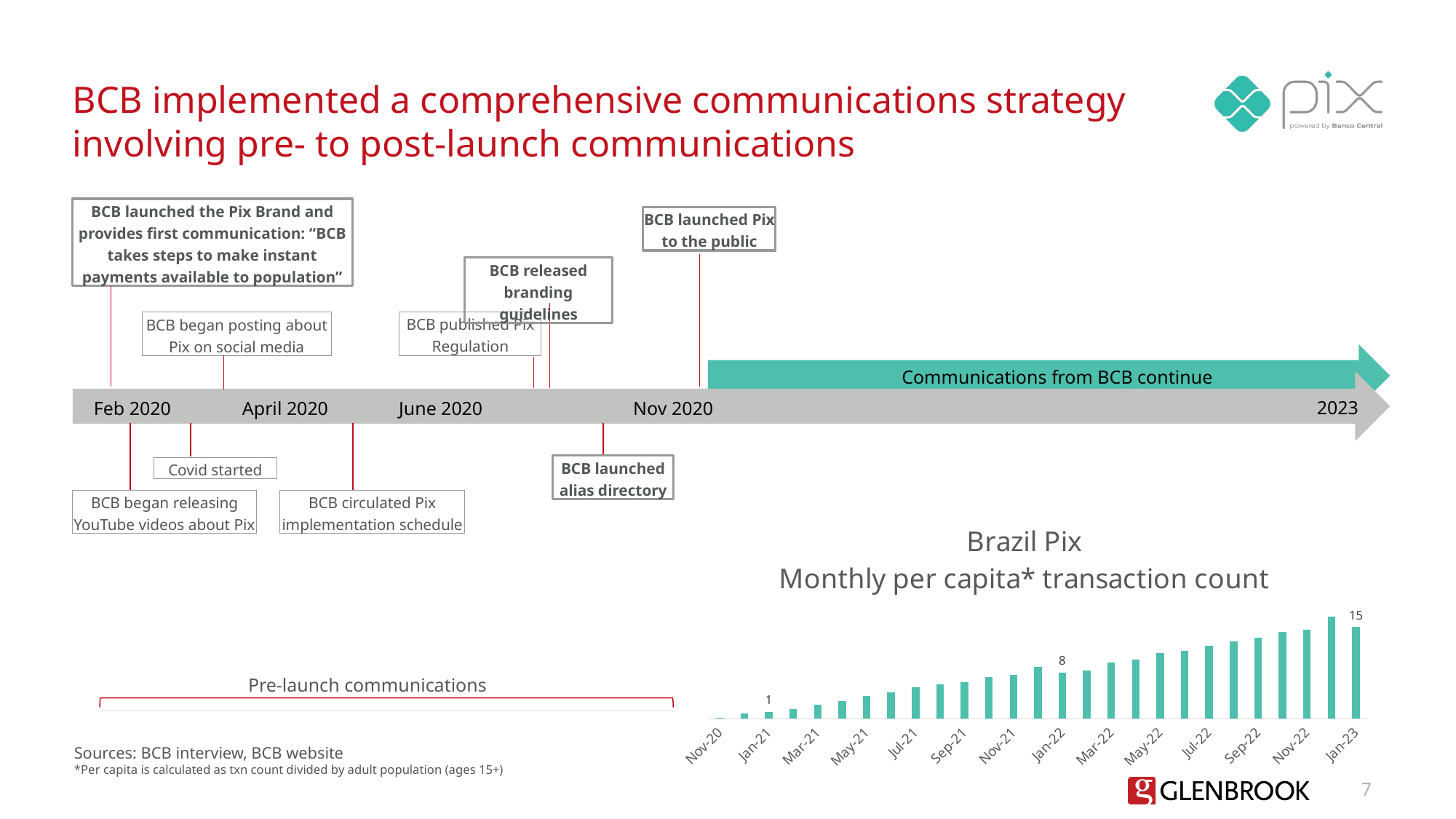
Do the per capita transaction counts rise or fall from Nov-20 to Jan-23? rise Which is larger, the per capita transaction count in Jan-22 or in Jan-21? Jan-22 What is the title of the chart on the slide? Brazil Pix Monthly per capita* transaction count What is the difference between the per capita transaction count in Jan-23 and Jan-22? 7 Which month has the lowest per capita transaction count? Nov-20 What is the monthly per capita transaction count for Jan-22? 8 What type of chart is shown on the slide? bar chart How many month labels are shown on the x axis of the chart? 14 Which month has the highest per capita transaction count? Dec-22 What is the difference between the per capita transaction count in Jan-22 and Jan-21? 7 What is the monthly per capita transaction count for Jan-21? 1 What is the monthly per capita transaction count for Jan-23? 15